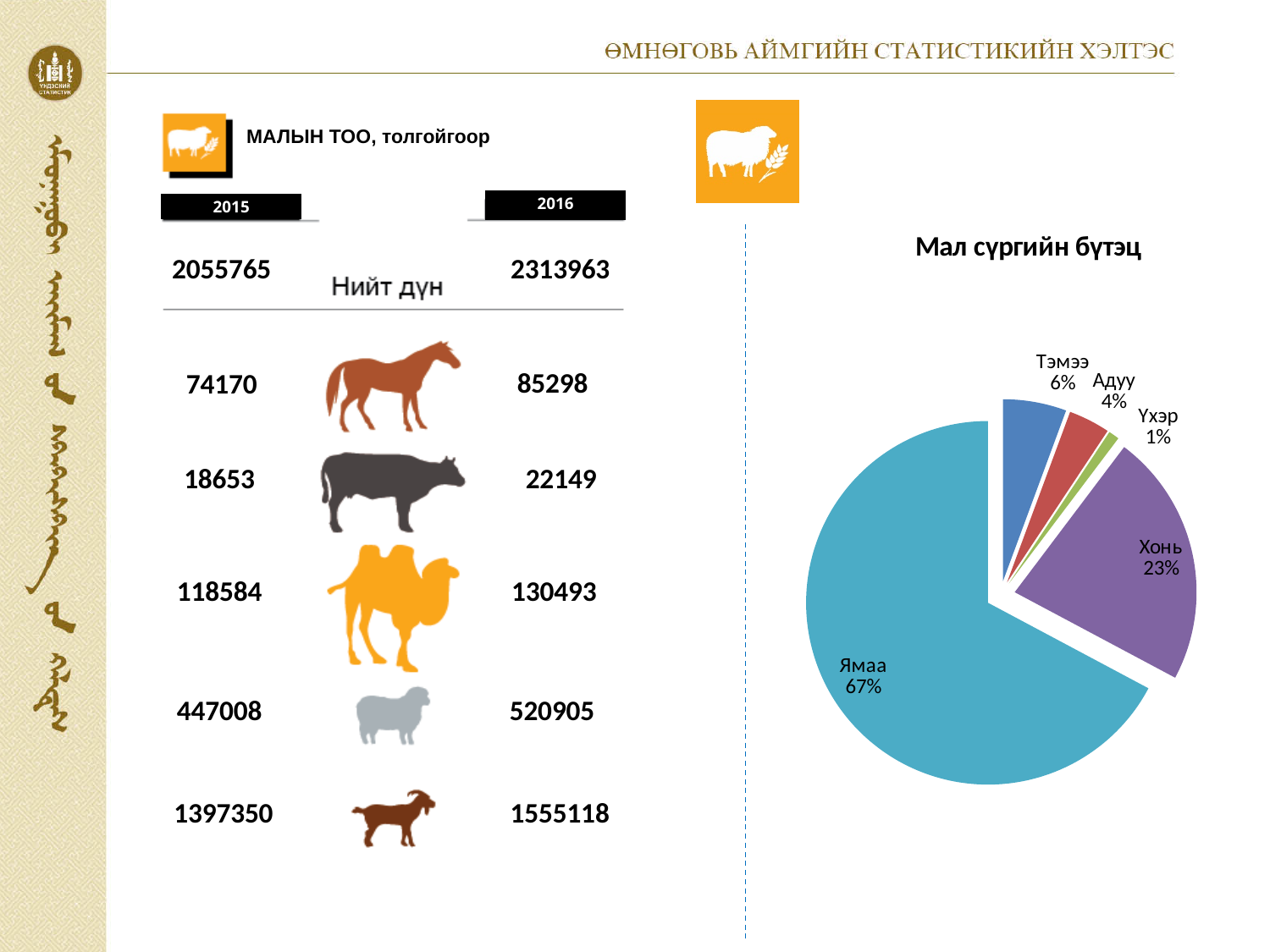
In the pie chart "Мал сүргийн бүтэц", what share does Адуу have? 4% In the pie chart "Мал сүргийн бүтэц", how many slices are there? 5 In the pie chart "Мал сүргийн бүтэц", what share does Ямаа have? 67% In the pie chart "Мал сүргийн бүтэц", what is the difference between the shares of Ямаа and Хонь? 44% What kind of chart is "Мал сүргийн бүтэц"? pie chart In the pie chart "Мал сүргийн бүтэц", what share does Хонь have? 23% In the pie chart "Мал сүргийн бүтэц", which category has the smallest slice? Үхэр In the pie chart "Мал сүргийн бүтэц", which category has the largest slice? Ямаа What is the title of the pie chart on the slide? Мал сүргийн бүтэц In the pie chart "Мал сүргийн бүтэц", which is larger, the share of Тэмээ or the share of Адуу? Тэмээ